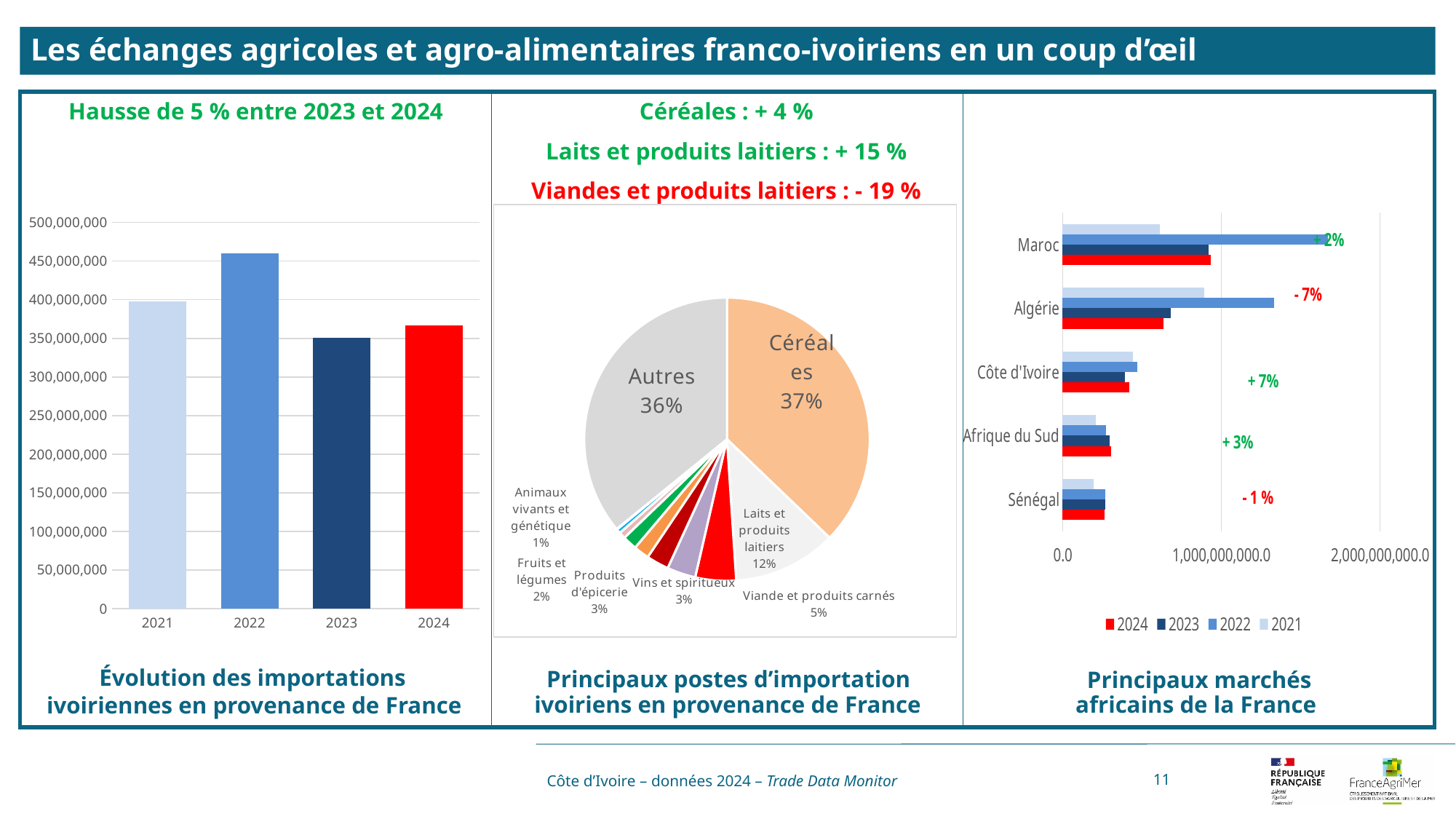
In the left chart 'Évolution des importations ivoiriennes en provenance de France', which year has the highest value? 2022 In the left chart 'Évolution des importations ivoiriennes en provenance de France', which is larger, the value for 2021 or the value for 2024? 2021 In the middle pie chart 'Principaux postes d'importation ivoiriens en provenance de France', what share does Céréales have? 37% In the middle pie chart 'Principaux postes d'importation ivoiriens en provenance de France', what share does Laits et produits laitiers have? 12% In the right chart 'Principaux marchés africains de la France', how many series does the legend list? 4 In the left chart 'Évolution des importations ivoiriennes en provenance de France', which year has the lowest value? 2023 In the left chart 'Évolution des importations ivoiriennes en provenance de France', is the value for 2024 greater or less than 400,000,000? less In the right chart 'Principaux marchés africains de la France', what percentage change is shown next to Algérie? - 7% What kind of chart is the left chart, 'Évolution des importations ivoiriennes en provenance de France'? bar chart In the right chart 'Principaux marchés africains de la France', is the 2022 value for Maroc greater or less than 1,000,000,000.0? greater